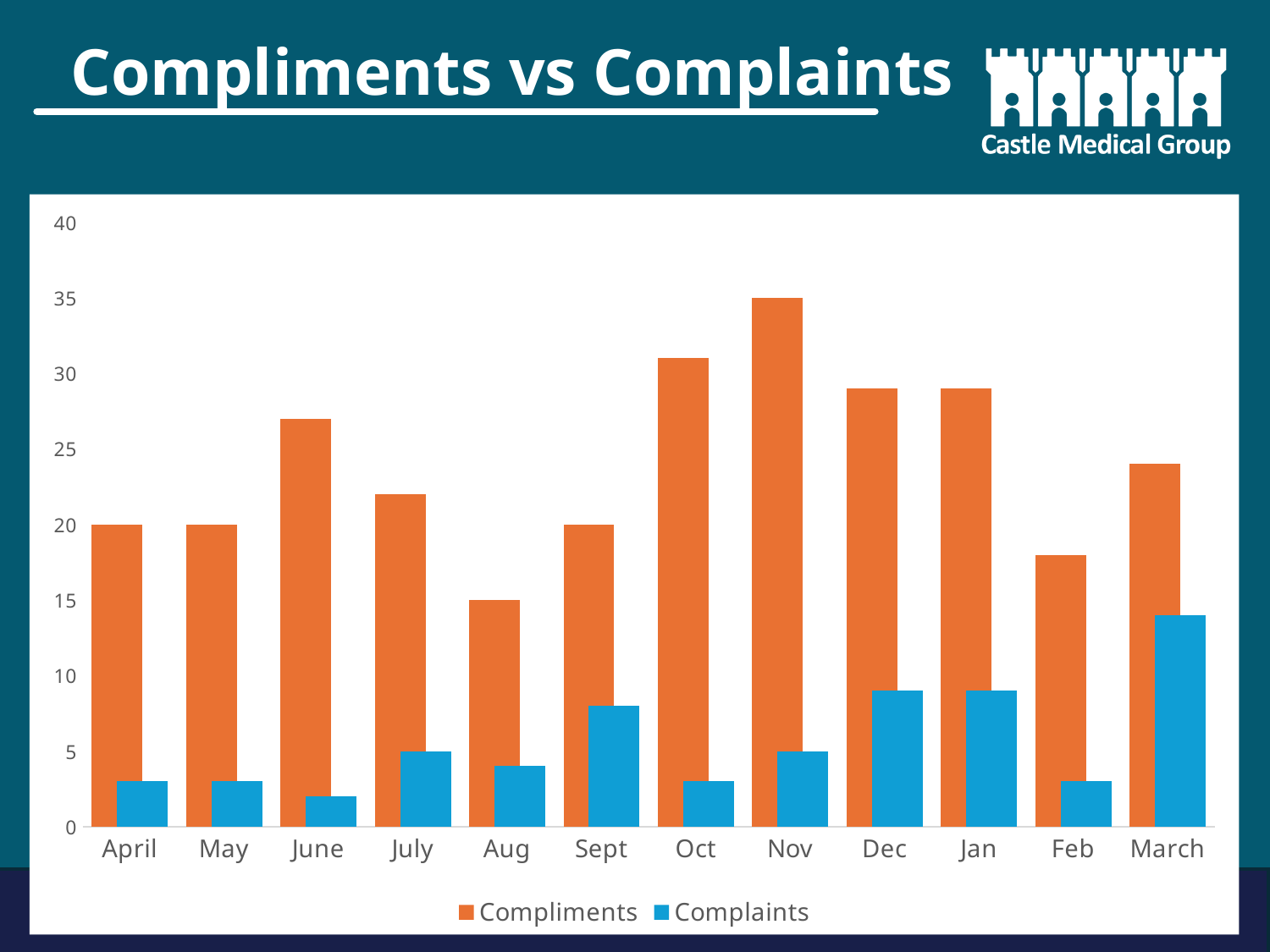
Which month has the highest Compliments value? Nov Is the Compliments value for Oct greater or less than 30? greater What is the Compliments value for April? 20 How many series does the legend list? 2 What is the Compliments value for Aug? 15 Which month has the lowest Compliments value? Aug Which month has the highest Complaints value? March How many months are shown on the x axis? 12 What is the Compliments value for Nov? 35 What type of chart is shown on the slide? bar chart Is the Complaints value for March greater or less than 10? greater What is the difference between the Compliments values for Nov and Aug? 20